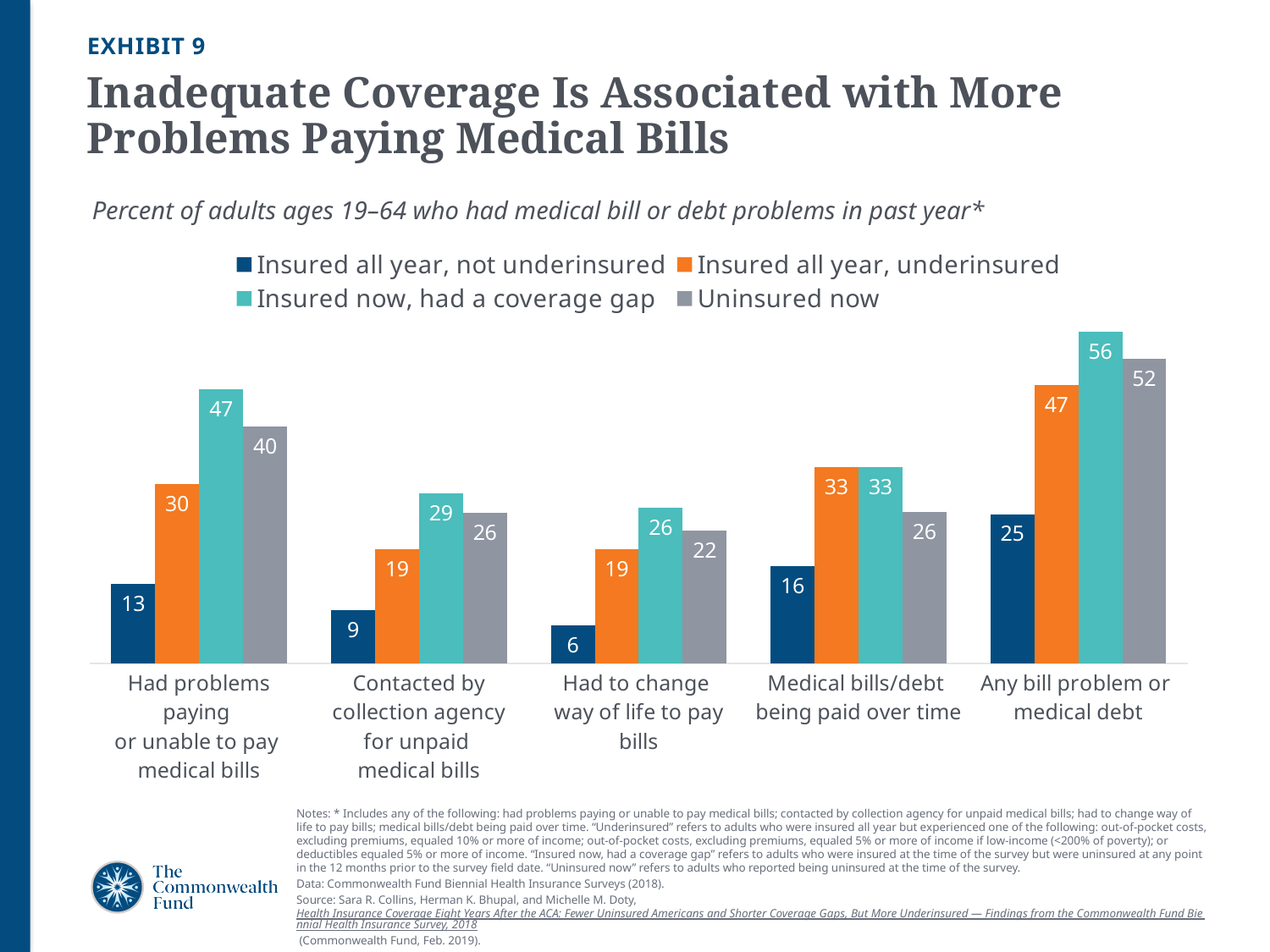
In the 'Medical bills/debt being paid over time' category, which is larger: the value for 'Insured all year, underinsured' or 'Uninsured now'? Insured all year, underinsured What is the value for 'Uninsured now' in the 'Had problems paying or unable to pay medical bills' category? 40 What is the difference between the 'Uninsured now' and 'Insured all year, not underinsured' values in the 'Any bill problem or medical debt' category? 27 What is the value for 'Insured now, had a coverage gap' in the 'Any bill problem or medical debt' category? 56 What is the value for 'Insured all year, not underinsured' in the 'Had to change way of life to pay bills' category? 6 Which series has the lowest value in the 'Contacted by collection agency for unpaid medical bills' category? Insured all year, not underinsured What colour represents the 'Insured all year, underinsured' series? Orange What kind of chart is shown on the slide? Bar chart In the 'Medical bills/debt being paid over time' category, what value do both 'Insured all year, underinsured' and 'Insured now, had a coverage gap' share? 33 Which series has the highest value in the 'Any bill problem or medical debt' category? Insured now, had a coverage gap How many categories are shown on the x axis? 5 How many series does the legend list? 4